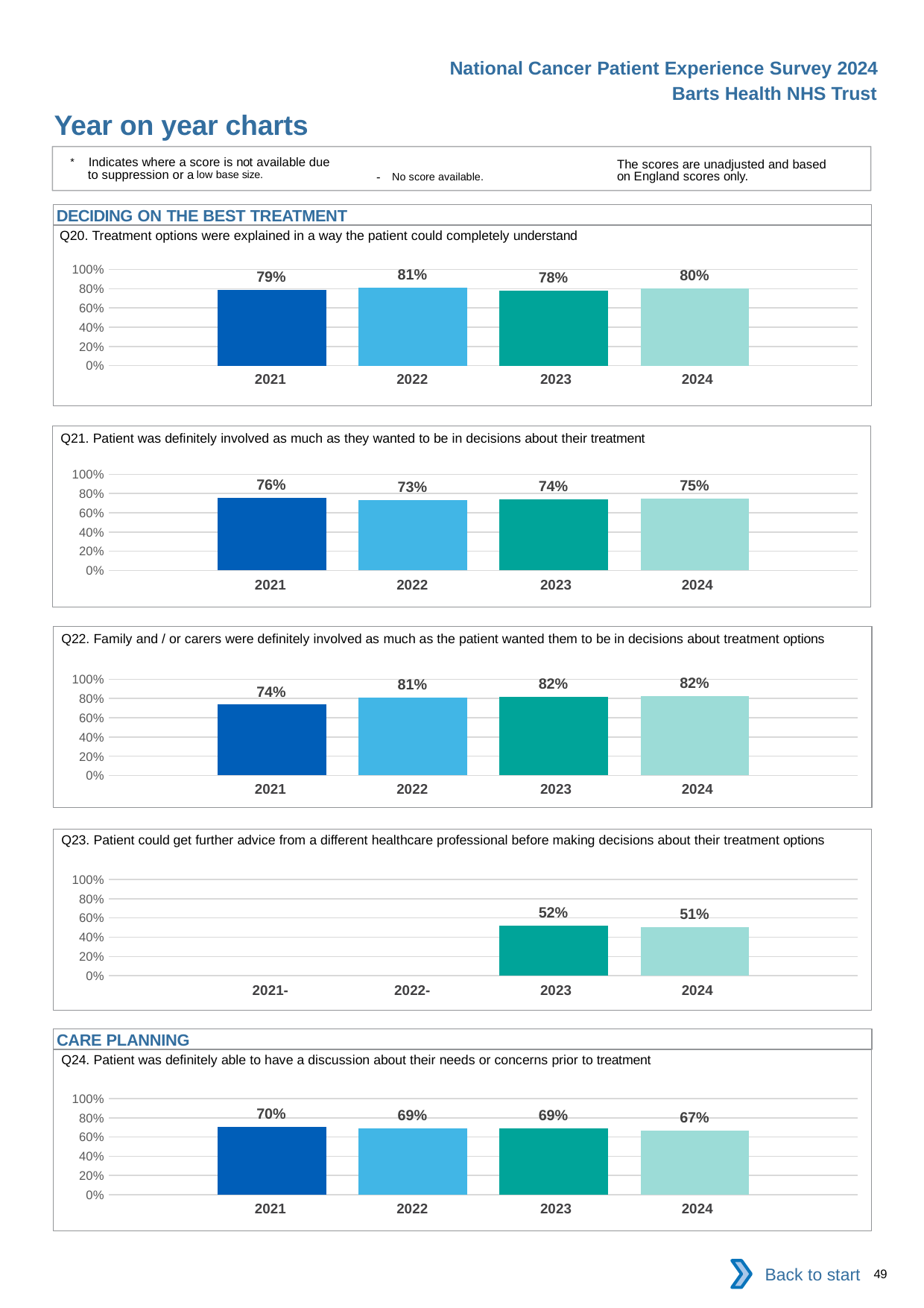
In the Q21 chart (Patient was definitely involved as much as they wanted to be in decisions about their treatment), what is the value for 2024? 75% In the Q23 chart, how many years have a bar plotted? 2 In the Q24 chart, do the values generally rise or fall from 2021 to 2024? fall In the Q20 chart (Treatment options were explained in a way the patient could completely understand), what is the value for 2022? 81% What kind of chart is the Q20 chart? bar chart In the Q21 chart, which year has the highest value? 2021 In the Q22 chart (Family and / or carers were definitely involved), what is the difference between the 2021 and 2022 values? 7 percentage points In the Q23 chart (Patient could get further advice from a different healthcare professional), what is the value for 2023? 52% In the Q24 chart (Patient was definitely able to have a discussion about their needs or concerns prior to treatment), what is the value for 2024? 67% In the Q23 chart, is the value for 2024 greater or less than 60%? less In the Q20 chart, which year has the lowest value? 2023 In the Q22 chart, which is larger, the value for 2021 or the value for 2023? 2023